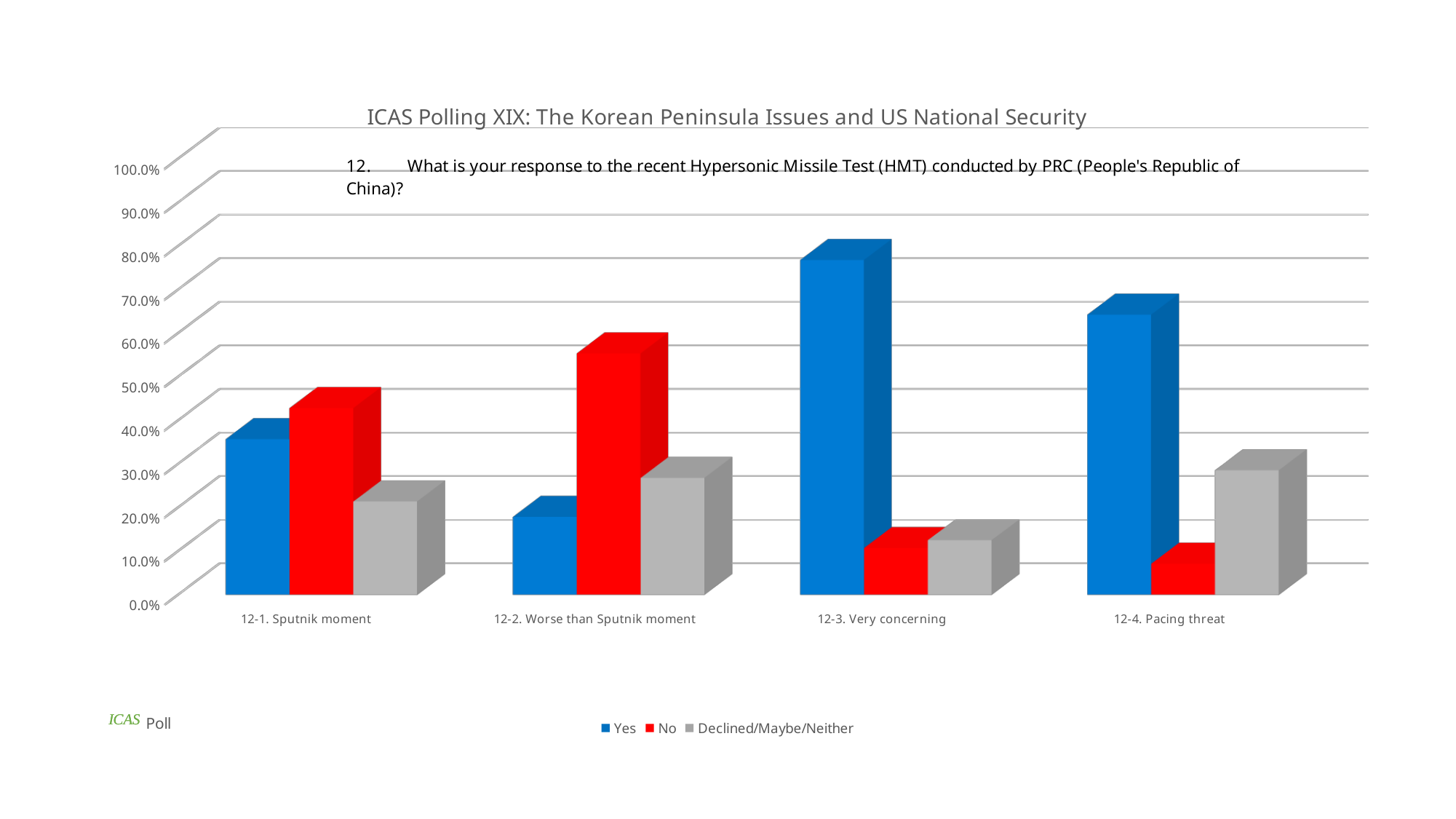
Which category has the highest Yes value? 12-3. Very concerning Is the No value for 12-3. Very concerning greater or less than 20.0%? less For 12-1. Sputnik moment, which is larger, the Yes value or the No value? No For 12-4. Pacing threat, which is larger, the Yes value or the No value? Yes How many series does the legend list? 3 Which colour represents the No series in the legend? red Which category has the highest No value? 12-2. Worse than Sputnik moment Is the Yes value for 12-3. Very concerning greater or less than 70.0%? greater What kind of chart is shown on the slide? bar chart Is the Yes value for 12-2. Worse than Sputnik moment greater or less than 30.0%? less Which category has the lowest Yes value? 12-2. Worse than Sputnik moment How many response categories are shown along the x axis? 4